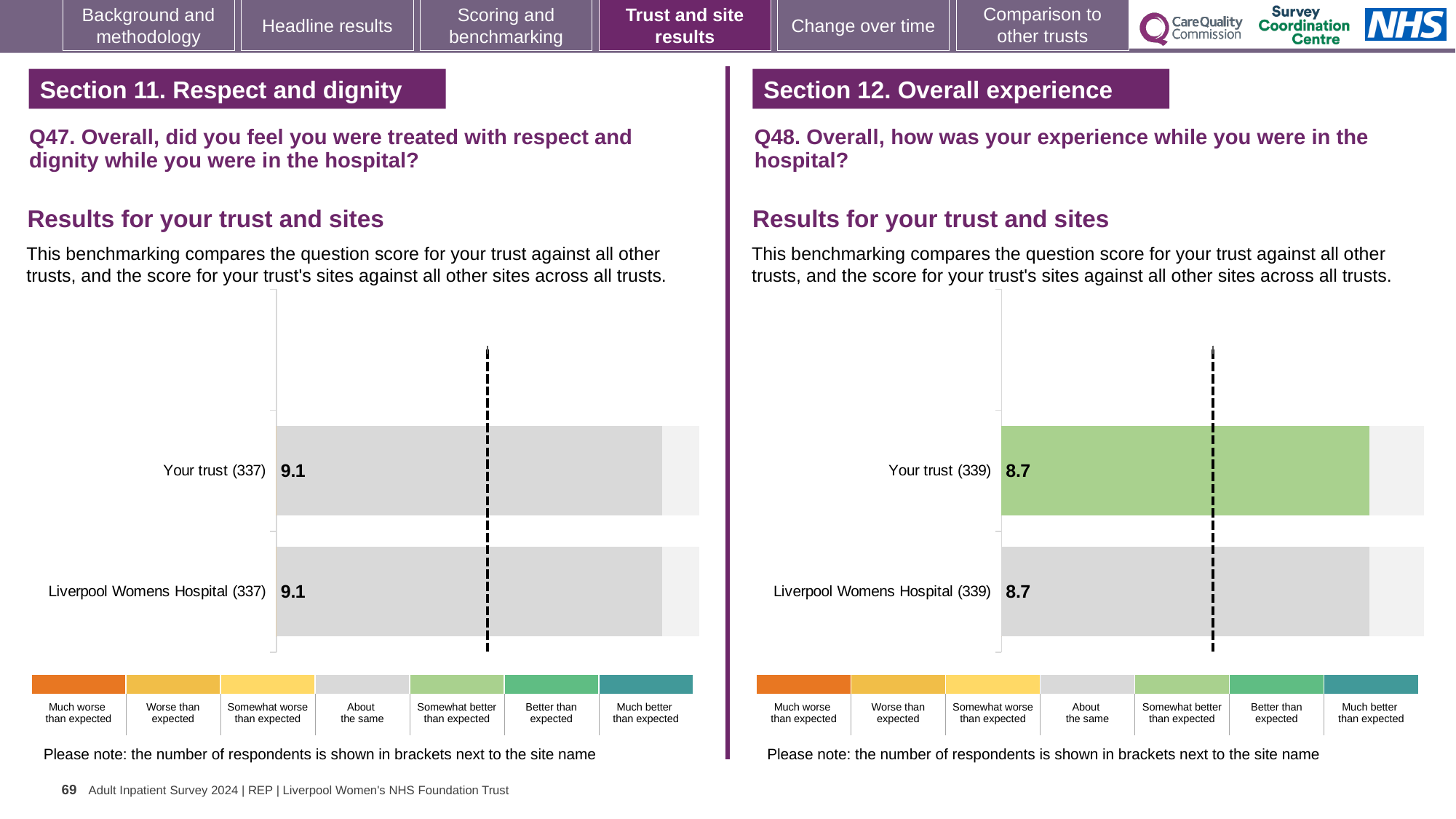
What kind of chart is used for the Q47 results on the left? Bar chart In the Q48 chart on the right, what is the difference between the Your trust score and the Liverpool Womens Hospital score? 0 In the Q47 chart on the left, how many respondents are shown in brackets for Your trust? 337 In the Q47 chart on the left, what is the score for Liverpool Womens Hospital? 9.1 In the Q48 chart on the right, what is the score for Your trust? 8.7 How many bars are plotted in the Q47 chart on the left? 2 In the Q47 chart on the left, what is the difference between the Your trust score and the Liverpool Womens Hospital score? 0 How many bars are plotted in the Q48 chart on the right? 2 In the Q48 chart on the right, which benchmark category does the green colour of the Your trust bar represent according to the key? Somewhat better than expected In the Q48 chart on the right, how many respondents are shown in brackets for Liverpool Womens Hospital? 339 In the Q47 chart on the left, what is the score for Your trust? 9.1 In the Q48 chart on the right, what is the score for Liverpool Womens Hospital? 8.7